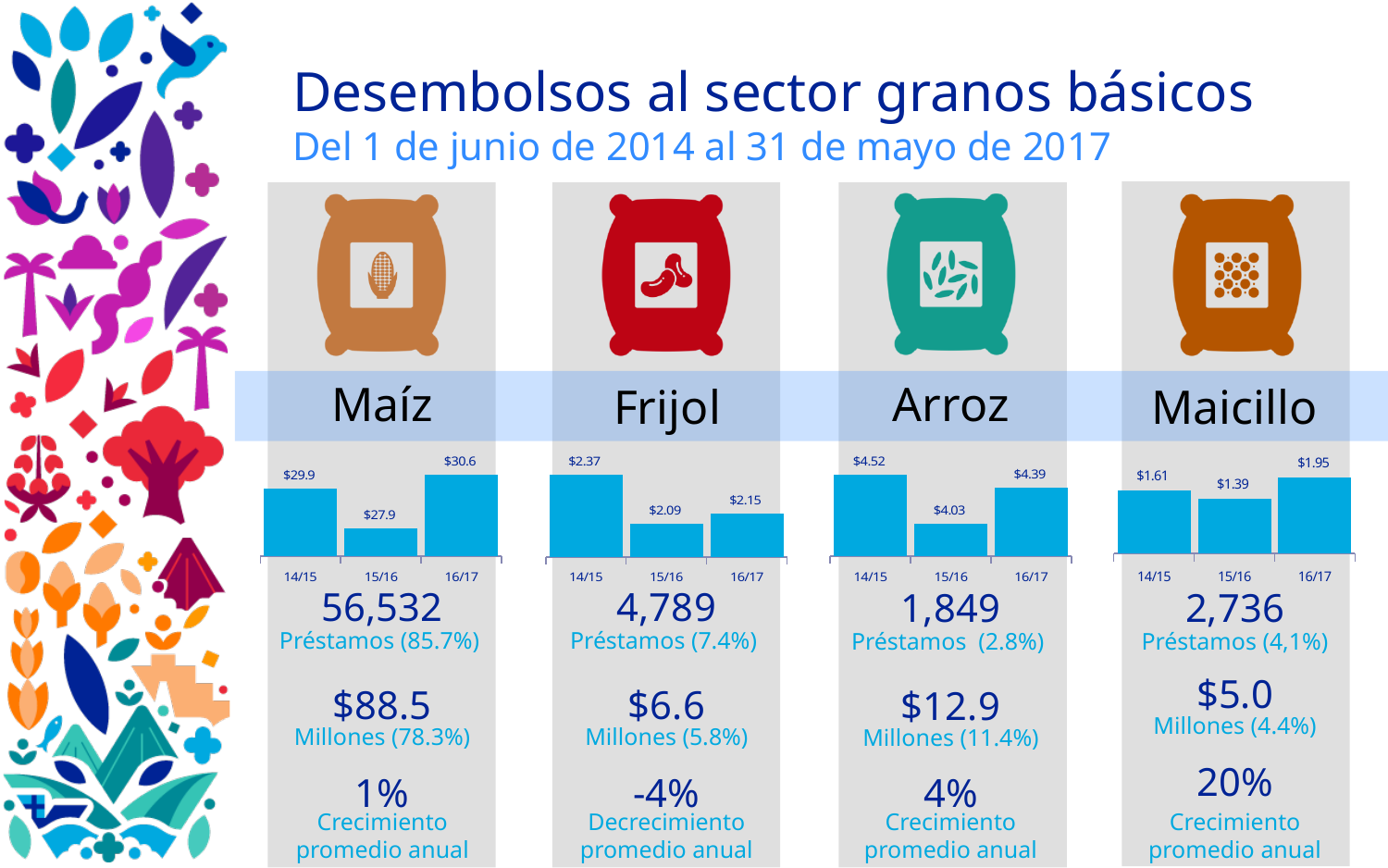
In the Maicillo chart, what is the difference between the 16/17 and 14/15 values? $0.34 In the Frijol chart, which is larger, the value for 14/15 or the value for 16/17? 14/15 What kind of chart is used for Maíz? bar chart In the Maicillo chart, which period has the highest value? 16/17 In the Maicillo chart, what is the value for 15/16? $1.39 In the Arroz chart, what is the value for 14/15? $4.52 How many small bar charts are shown on the slide? 4 In the Maíz chart, what is the value for 16/17? $30.6 In the Arroz chart, what is the difference between the 14/15 and 15/16 values? $0.49 In the Maíz chart, which period has the lowest value? 15/16 How many bars are in the Arroz chart? 3 In the Frijol chart, what is the value for 15/16? $2.09